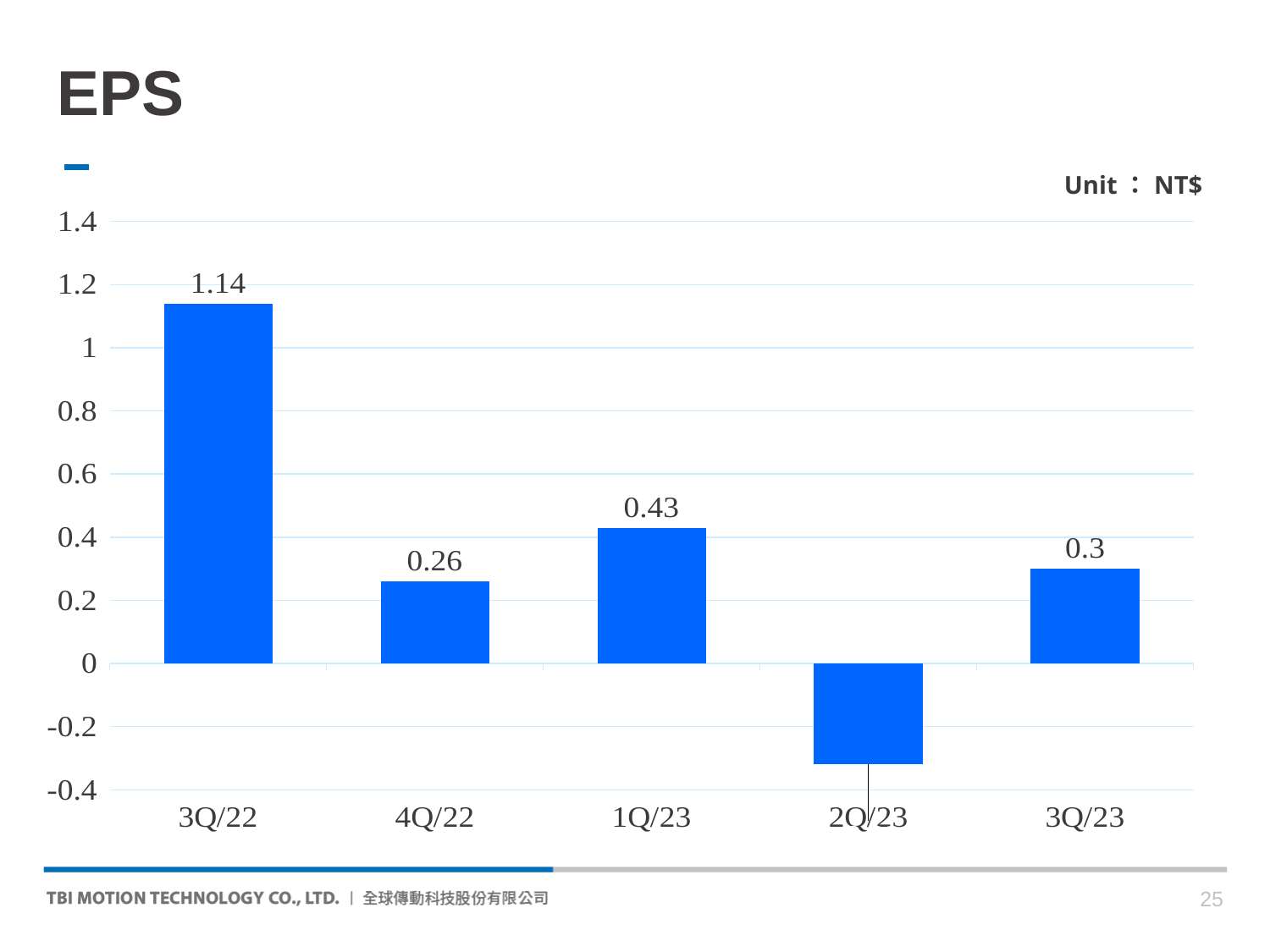
How many quarters are shown on the chart? 5 Which quarter has the lowest EPS? 2Q/23 What is the EPS value for 3Q/22? 1.14 What is the EPS value for 4Q/22? 0.26 What unit is stated for the EPS chart? NT$ What is the EPS value for 1Q/23? 0.43 What is the EPS value for 3Q/23? 0.3 What is the difference between the EPS for 3Q/22 and 1Q/23? 0.71 What kind of chart is shown on the slide? bar chart Which is larger, the EPS for 4Q/22 or 3Q/23? 3Q/23 Which quarter has the highest EPS? 3Q/22 Is the EPS value for 2Q/23 greater or less than -0.2? less